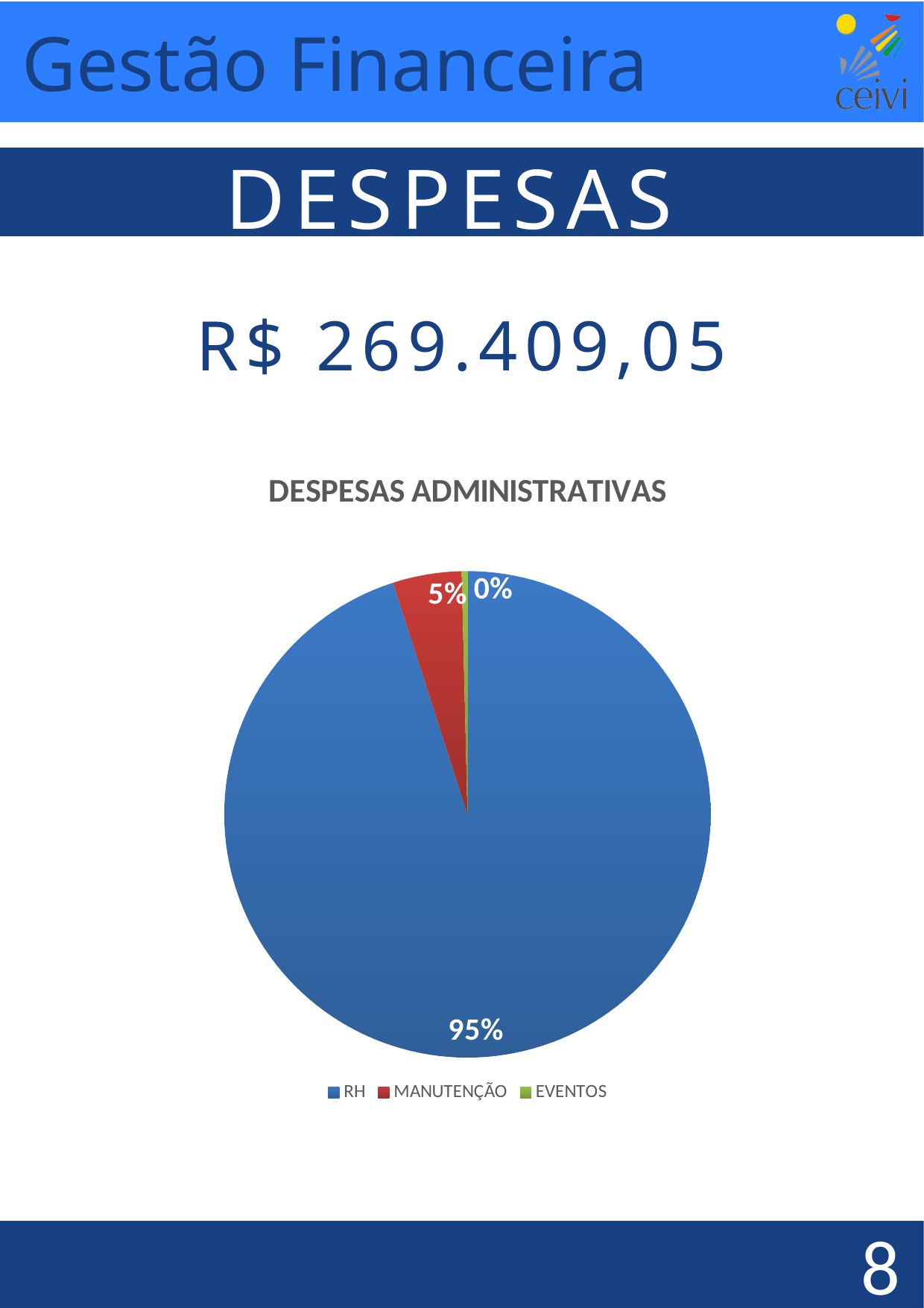
Which category has the largest slice of the pie? RH What share of the pie does RH represent? 95% What is the title of the chart? DESPESAS ADMINISTRATIVAS What is the difference in percentage points between the RH slice and the MANUTENÇÃO slice? 90 Which category has the smallest slice of the pie? EVENTOS What share of the pie does MANUTENÇÃO represent? 5% What colour is the RH slice in the pie chart? blue What share of the pie does EVENTOS represent? 0% What kind of chart is shown on the slide? pie chart How many categories does the legend list? 3 Is the share for RH greater or less than 50%? greater Which slice is larger, MANUTENÇÃO or EVENTOS? MANUTENÇÃO